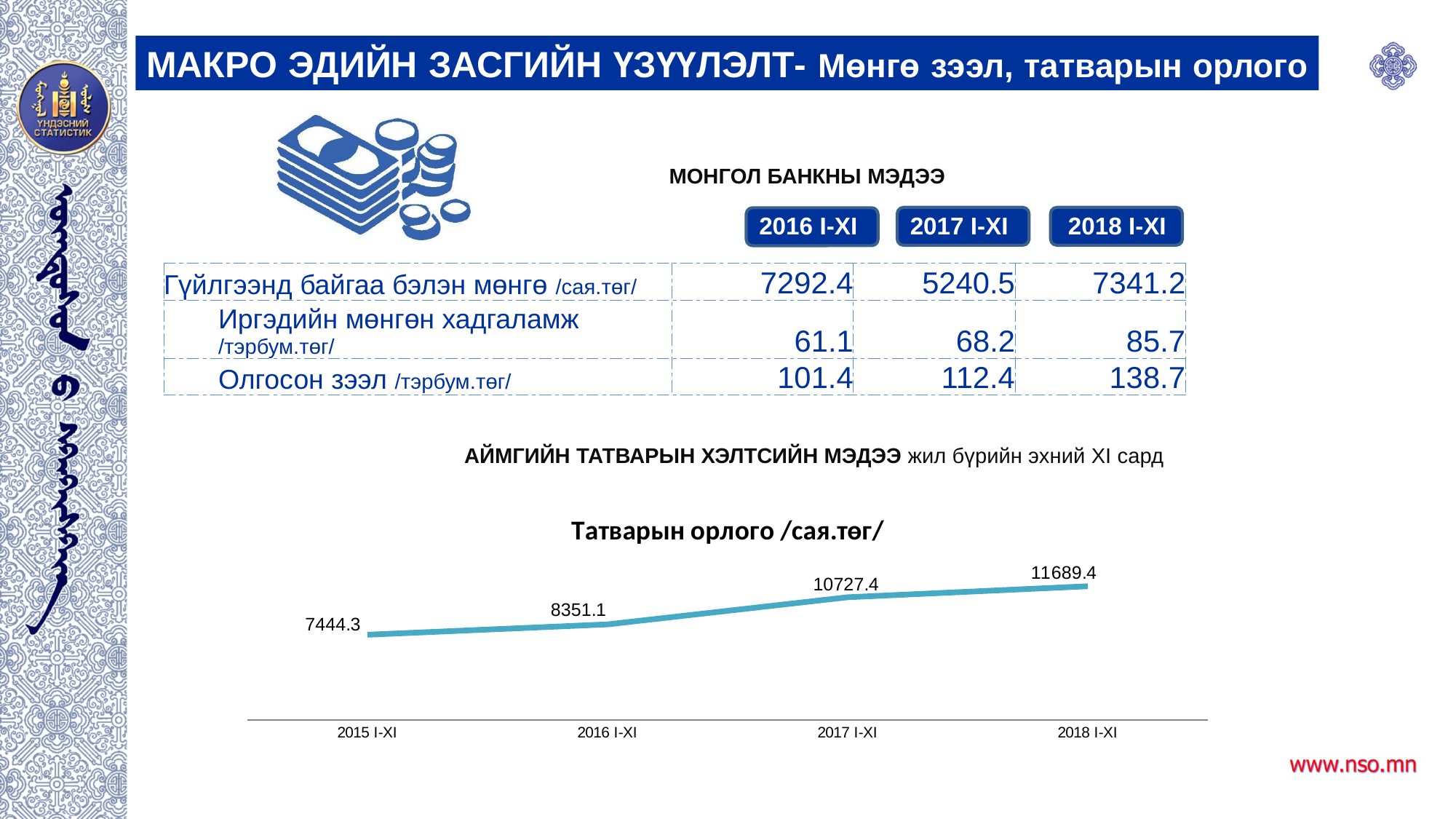
What is the value for 2017 I-XI in the chart? 10727.4 Which is larger in the chart, the value for 2016 I-XI or the value for 2017 I-XI? 2017 I-XI What type of chart is shown on the slide? line chart Which period has the lowest value in the chart? 2015 I-XI Which period has the highest value in the chart? 2018 I-XI What is the title of the chart? Татварын орлого /сая.төг/ What is the value for 2018 I-XI in the chart? 11689.4 What is the difference between the values for 2018 I-XI and 2015 I-XI in the chart? 4245.1 What is the value for 2016 I-XI in the chart? 8351.1 What is the difference between the values for 2017 I-XI and 2016 I-XI in the chart? 2376.3 What is the value for 2015 I-XI in the chart? 7444.3 How many data points are plotted in the chart? 4